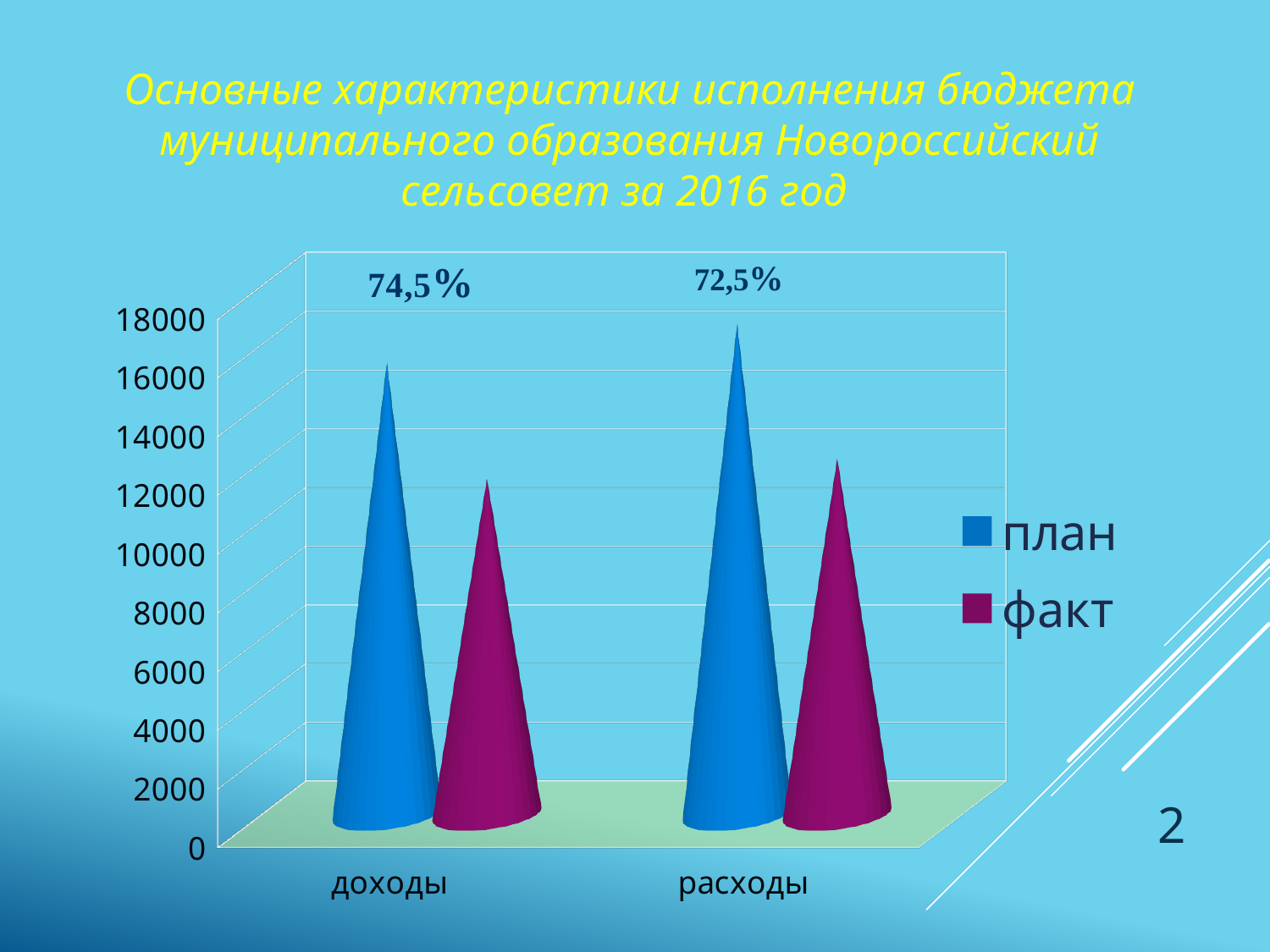
Which category has the tallest bar in the chart? расходы (план) How many categories are shown on the x axis of the chart? 2 Is the план value for доходы greater or less than 14000? greater What colour represents the план series in the chart? blue What percentage is printed above the расходы category? 72,5% For доходы, which is larger: план or факт? план What kind of chart is shown on the slide? bar chart Which bar is the lowest in the chart? факт for доходы What are the two series listed in the chart legend? план, факт What percentage is printed above the доходы category? 74,5% How many series does the chart legend list? 2 Is the факт value for расходы greater or less than 16000? less